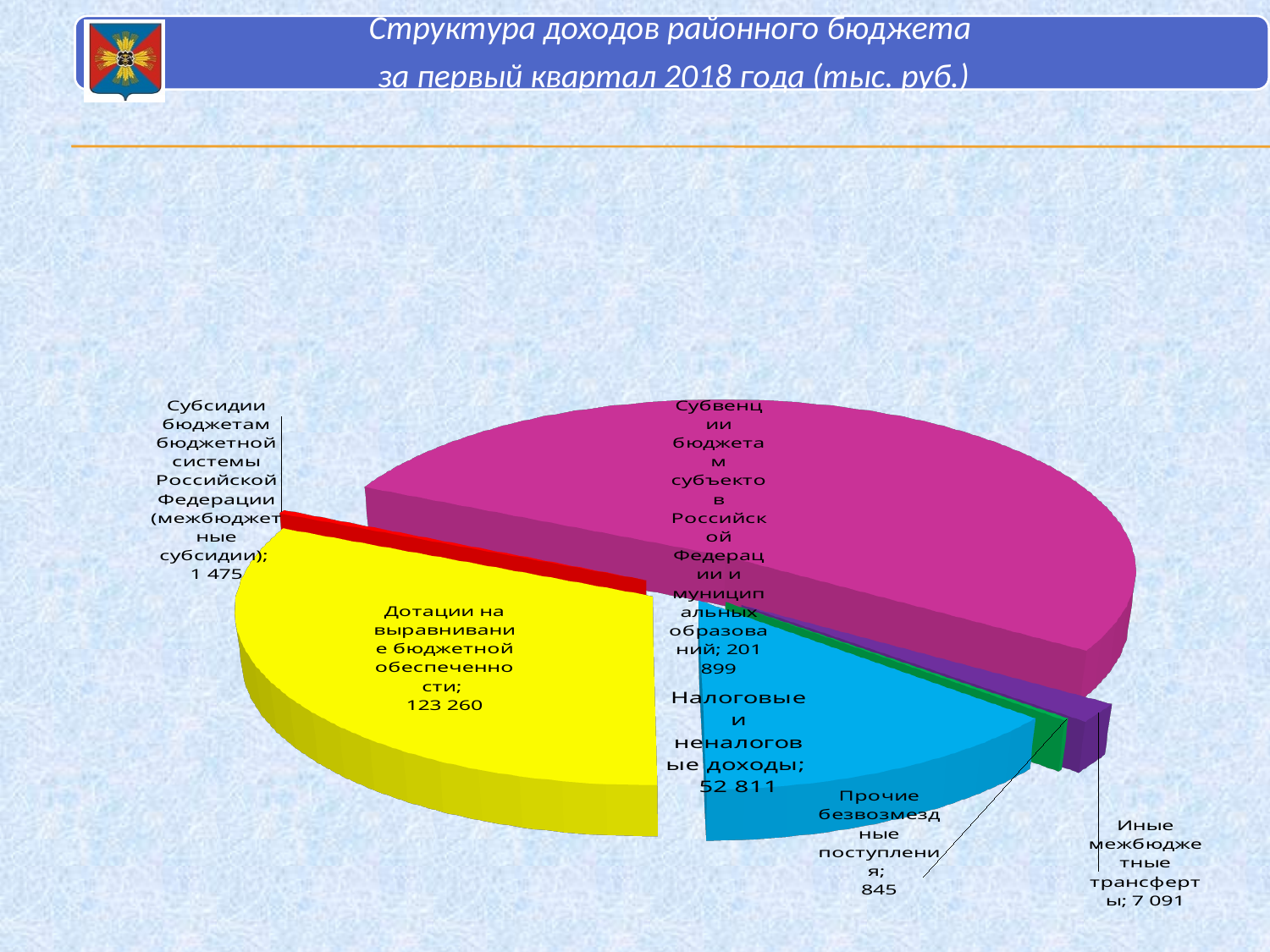
What is the value for Налоговые и неналоговые доходы? 52 811 Which is larger: Иные межбюджетные трансферты or Субсидии бюджетам бюджетной системы Российской Федерации (межбюджетные субсидии)? Иные межбюджетные трансферты What is the value for Иные межбюджетные трансферты? 7 091 What is the value for Прочие безвозмездные поступления? 845 What kind of chart is shown on the slide? Pie chart Which category has the smallest value in the pie chart? Прочие безвозмездные поступления What is the value for Дотации на выравнивание бюджетной обеспеченности? 123 260 What is the difference between the values for Субвенции бюджетам субъектов Российской Федерации и муниципальных образований and Дотации на выравнивание бюджетной обеспеченности? 78 639 What is the title of the chart on the slide? Структура доходов районного бюджета за первый квартал 2018 года (тыс. руб.) Which category has the largest value in the pie chart? Субвенции бюджетам субъектов Российской Федерации и муниципальных образований What is the total of all slices in the pie chart? 387 381 How many slices does the pie chart have? 6